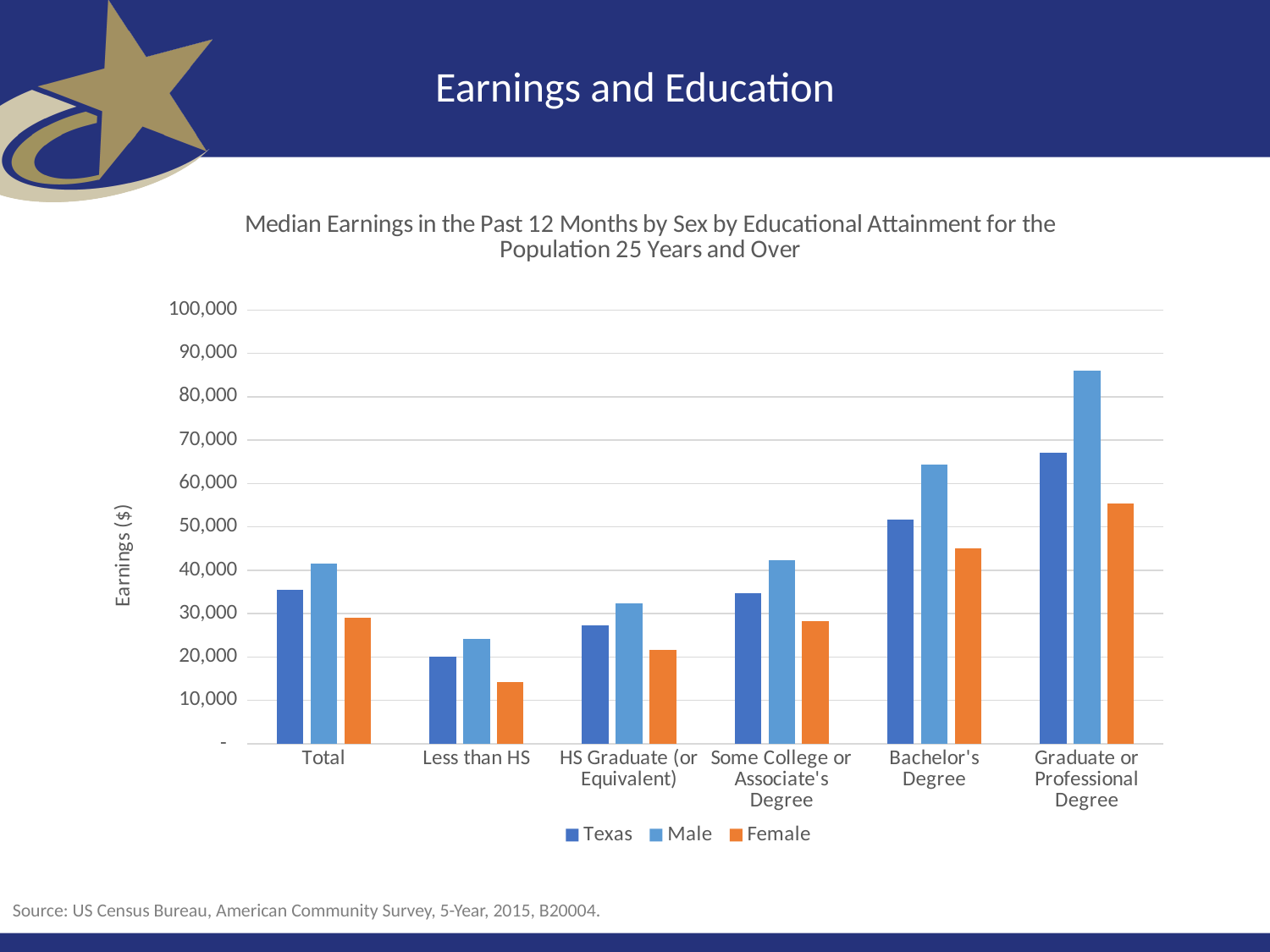
Which category has the lowest Female median earnings? Less than HS Which category has the highest Male median earnings? Graduate or Professional Degree For Bachelor's Degree, which is larger, the Male value or the Female value? Male How many series does the legend list? 3 Which is larger, the Female value for Total or the Female value for HS Graduate (or Equivalent)? Total Is the Male value for Graduate or Professional Degree greater or less than 80,000? greater Is the Female value for Less than HS greater or less than 20,000? less How many educational attainment categories are shown on the x axis? 6 What is the label on the vertical axis? Earnings ($) Do the Texas values rise or fall moving from Less than HS to Graduate or Professional Degree along the x axis? rise Is the Texas value for Graduate or Professional Degree greater or less than 60,000? greater What kind of chart is shown on the slide? bar chart